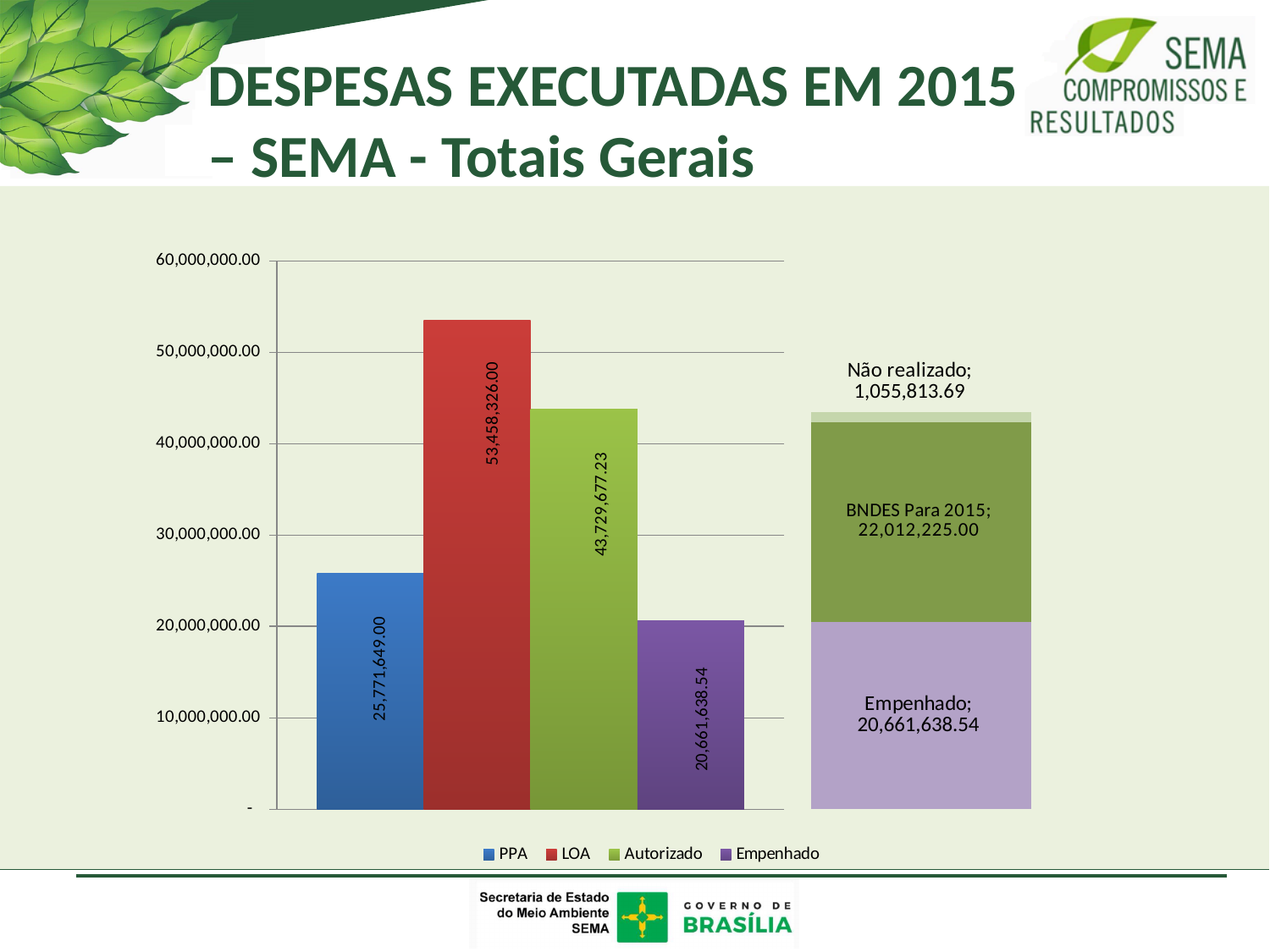
What is the value of the PPA bar? 25,771,649.00 Which series has the highest value among PPA, LOA, Autorizado and Empenhado? LOA What is the value of the 'Não realizado' segment in the stacked bar? 1,055,813.69 What is the value of the 'BNDES Para 2015' segment in the stacked bar? 22,012,225.00 What is the value of the Empenhado bar? 20,661,638.54 How many series does the legend list? 4 What is the value of the Autorizado bar? 43,729,677.23 Which series has the lowest value among PPA, LOA, Autorizado and Empenhado? Empenhado What kind of chart is shown on the slide? Bar chart What is the total of the stacked bar (Empenhado + BNDES Para 2015 + Não realizado)? 43,729,677.23 What is the difference between the LOA value and the PPA value? 27,686,677.00 What is the value of the LOA bar? 53,458,326.00